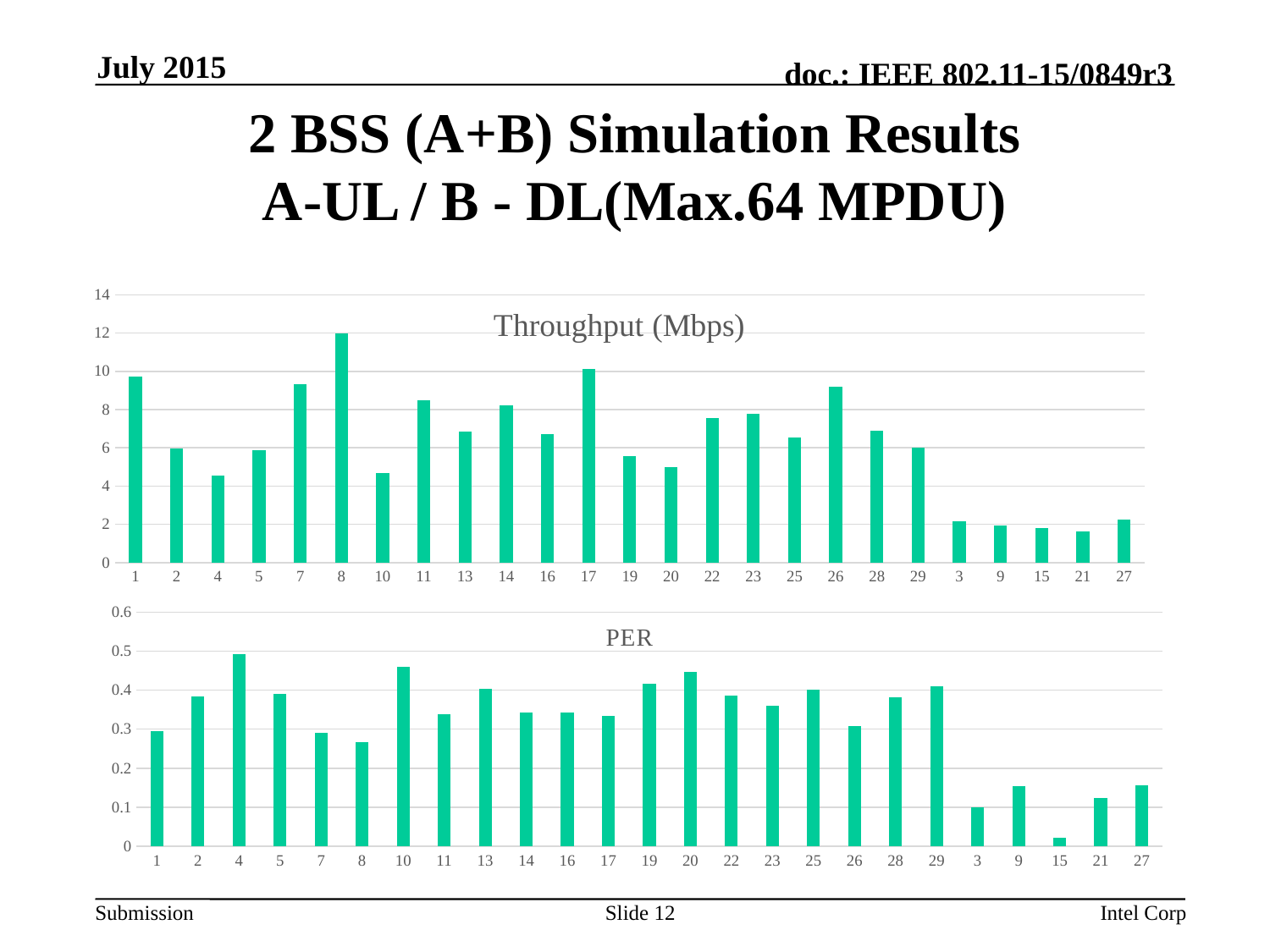
In the PER chart, is the value for category 8 greater or less than 0.3? less In the PER chart, is the value for category 20 greater or less than 0.4? greater In the Throughput (Mbps) chart, which category has the highest throughput? 8 In the Throughput (Mbps) chart, is the value for category 3 greater or less than 4? less In the PER chart, which has the higher PER, category 1 or category 2? 2 What is the title of the top chart on the slide? Throughput (Mbps) In the PER chart, which category has the highest PER? 4 How many categories are plotted on the PER chart? 25 What kind of chart is the Throughput (Mbps) chart? bar chart In the Throughput (Mbps) chart, which has the higher throughput, category 8 or category 10? 8 In the PER chart, which category has the lowest PER? 15